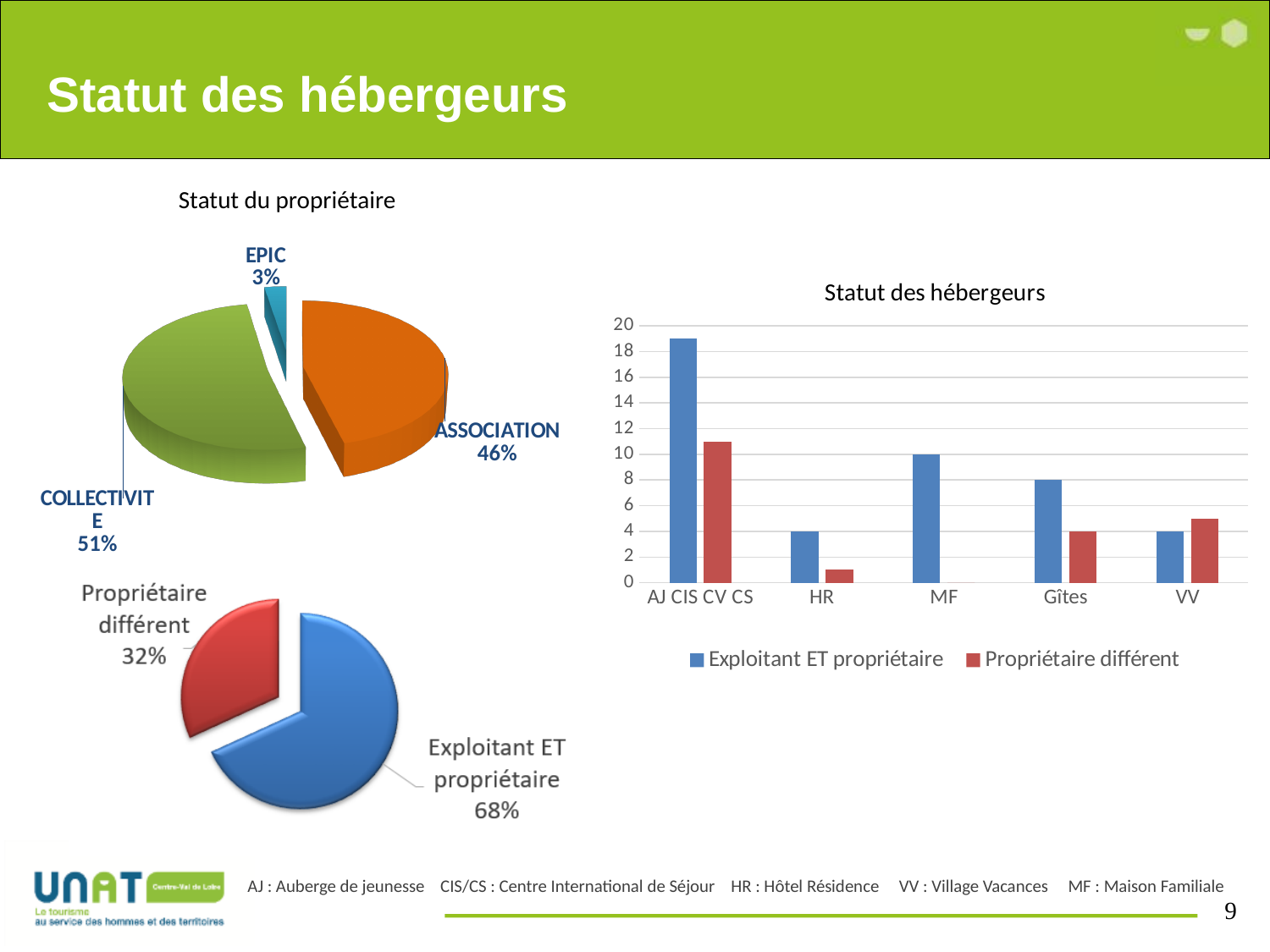
In the 'Statut du propriétaire' pie chart, what share does ASSOCIATION have? 46% In the 'Statut des hébergeurs' bar chart, is the 'Exploitant ET propriétaire' value for AJ CIS CV CS greater or less than 18? greater In the 'Statut des hébergeurs' bar chart, what is the value of 'Exploitant ET propriétaire' for MF? 10 What kind of chart is 'Statut des hébergeurs'? Bar chart In the bottom-left pie chart, what share does 'Exploitant ET propriétaire' have? 68% In the 'Statut des hébergeurs' bar chart, how many series does the legend list? 2 In the 'Statut des hébergeurs' bar chart, which category has the highest 'Exploitant ET propriétaire' value? AJ CIS CV CS In the 'Statut du propriétaire' pie chart, how many slices are there? 3 In the 'Statut du propriétaire' pie chart, which category has the largest share? COLLECTIVITE In the 'Statut du propriétaire' pie chart, which category has the smallest share? EPIC In the bottom-left pie chart, what is the difference between the 'Exploitant ET propriétaire' share and the 'Propriétaire différent' share? 36% In the 'Statut des hébergeurs' bar chart, what is the value of 'Propriétaire différent' for Gîtes? 4